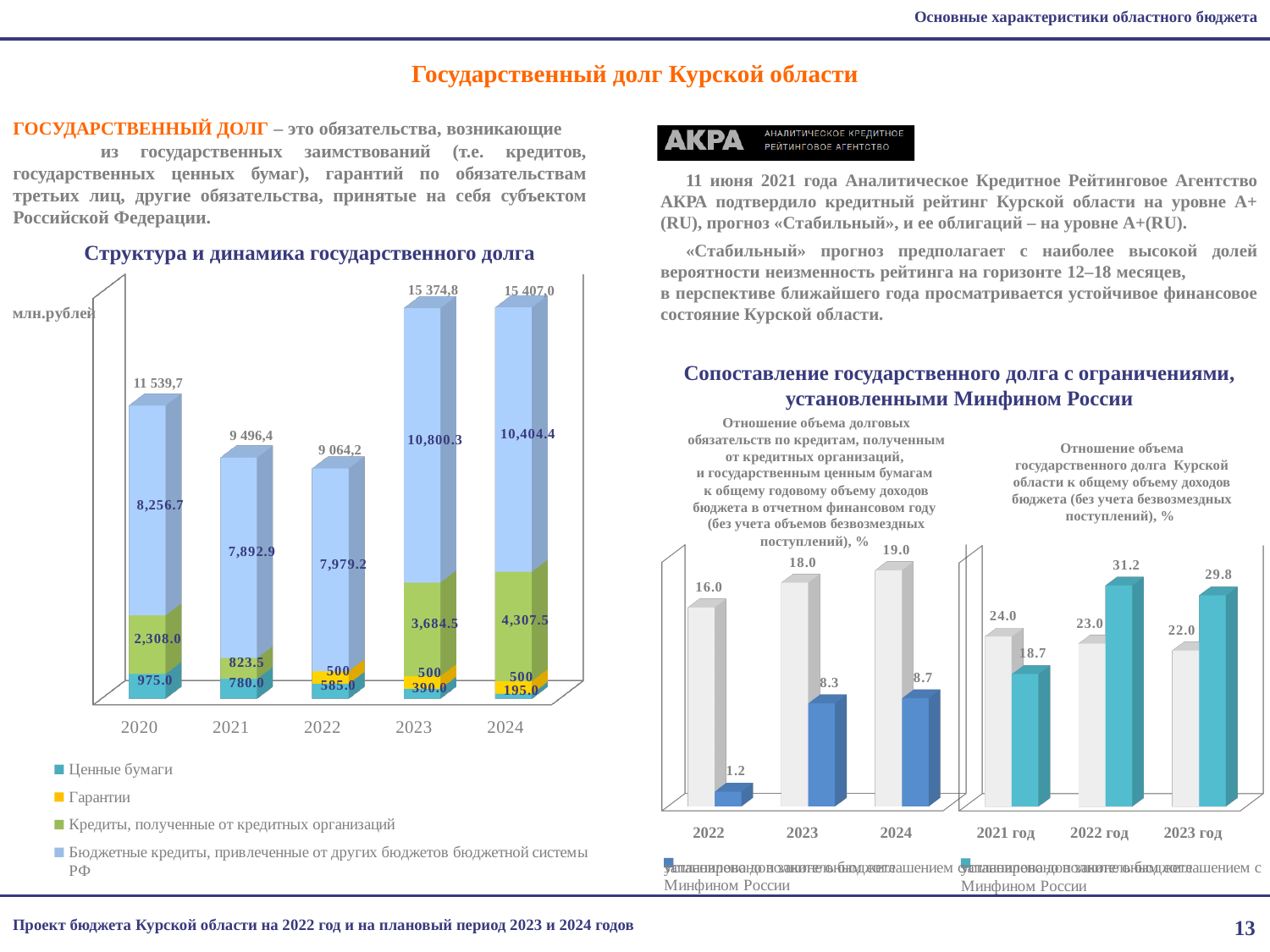
In the chart 'Структура и динамика государственного долга', what is the value of 'Бюджетные кредиты, привлеченные от других бюджетов бюджетной системы РФ' for 2024? 10,404.4 In the chart 'Структура и динамика государственного долга', which year has the lowest total state debt? 2022 In the chart 'Структура и динамика государственного долга', what is the value of 'Ценные бумаги' for 2020? 975.0 In the chart 'Структура и динамика государственного долга', which is larger: 'Ценные бумаги' in 2021 or in 2022? 2021 In the middle chart 'Отношение объема долговых обязательств по кредитам...', what is the value of the blue bar for 2022? 1.2 In the chart 'Структура и динамика государственного долга', how many series does the legend list? 4 What type of chart is 'Структура и динамика государственного долга'? Stacked bar chart In the chart 'Структура и динамика государственного долга', how many years are shown on the x axis? 5 In the chart 'Структура и динамика государственного долга', what is the total state debt shown for 2023? 15 374,8 In the chart 'Структура и динамика государственного долга', which year has the highest total state debt? 2024 In the right chart 'Отношение объема государственного долга Курской области к общему объему доходов бюджета', what is the value of the teal bar for 2022 год? 31.2 In the chart 'Структура и динамика государственного долга', what is the difference between the 'Кредиты, полученные от кредитных организаций' values for 2024 and 2023? 623.0